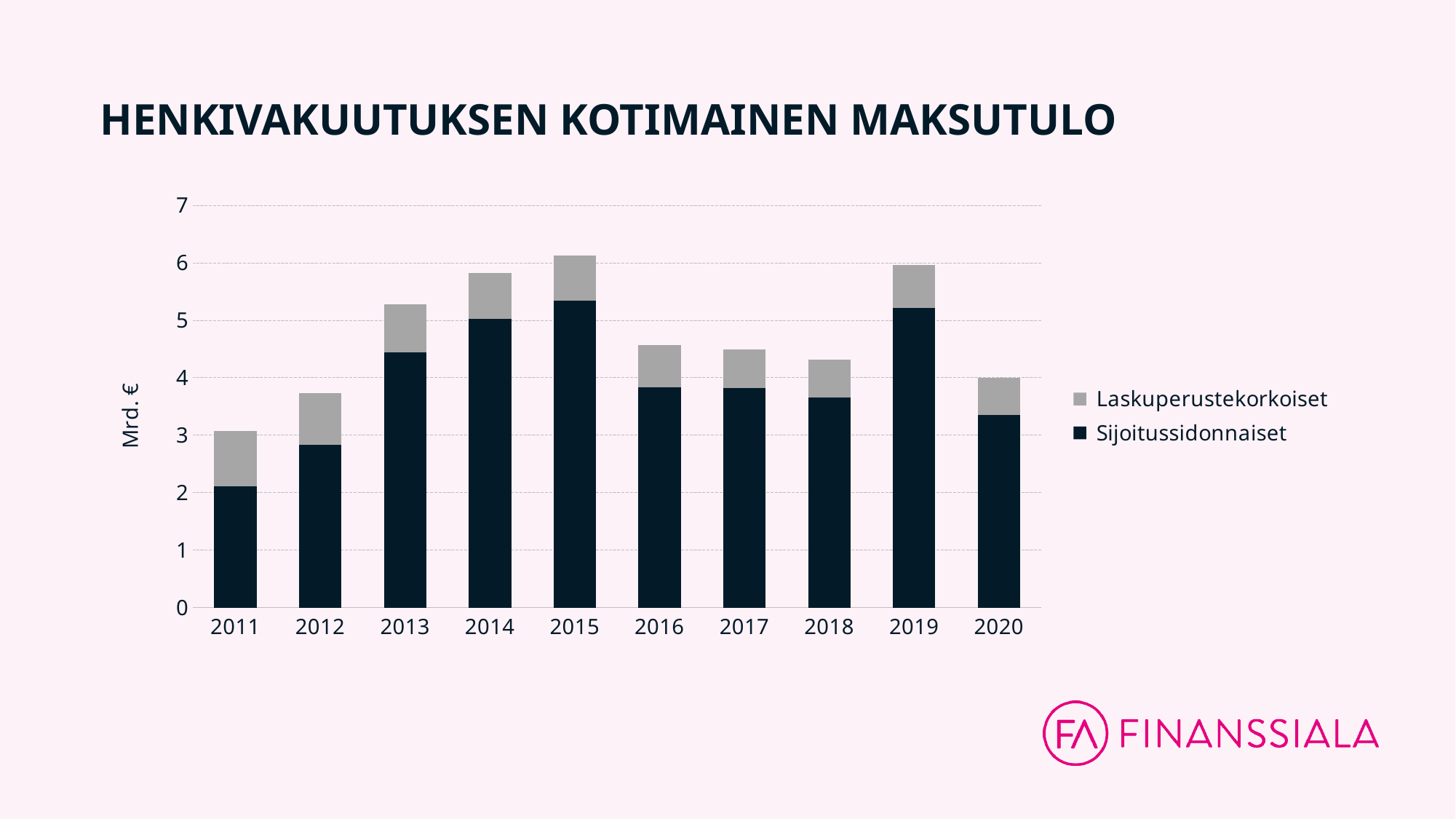
What kind of chart is shown on the slide? Stacked bar chart Which year has the larger total bar, 2012 or 2013? 2013 Is the total bar for 2013 greater or less than 5? greater Is the Sijoitussidonnaiset value for 2015 greater or less than 5? greater Which year has the lowest total bar in the chart? 2011 Is the total bar for 2011 greater or less than 4? less How many series does the chart's legend list? 2 What is the label on the y axis of the chart? Mrd. € Do the total bars rise or fall from 2015 to 2018? fall How many years are shown on the x axis of the chart? 10 What is the title of the chart? HENKIVAKUUTUKSEN KOTIMAINEN MAKSUTULO